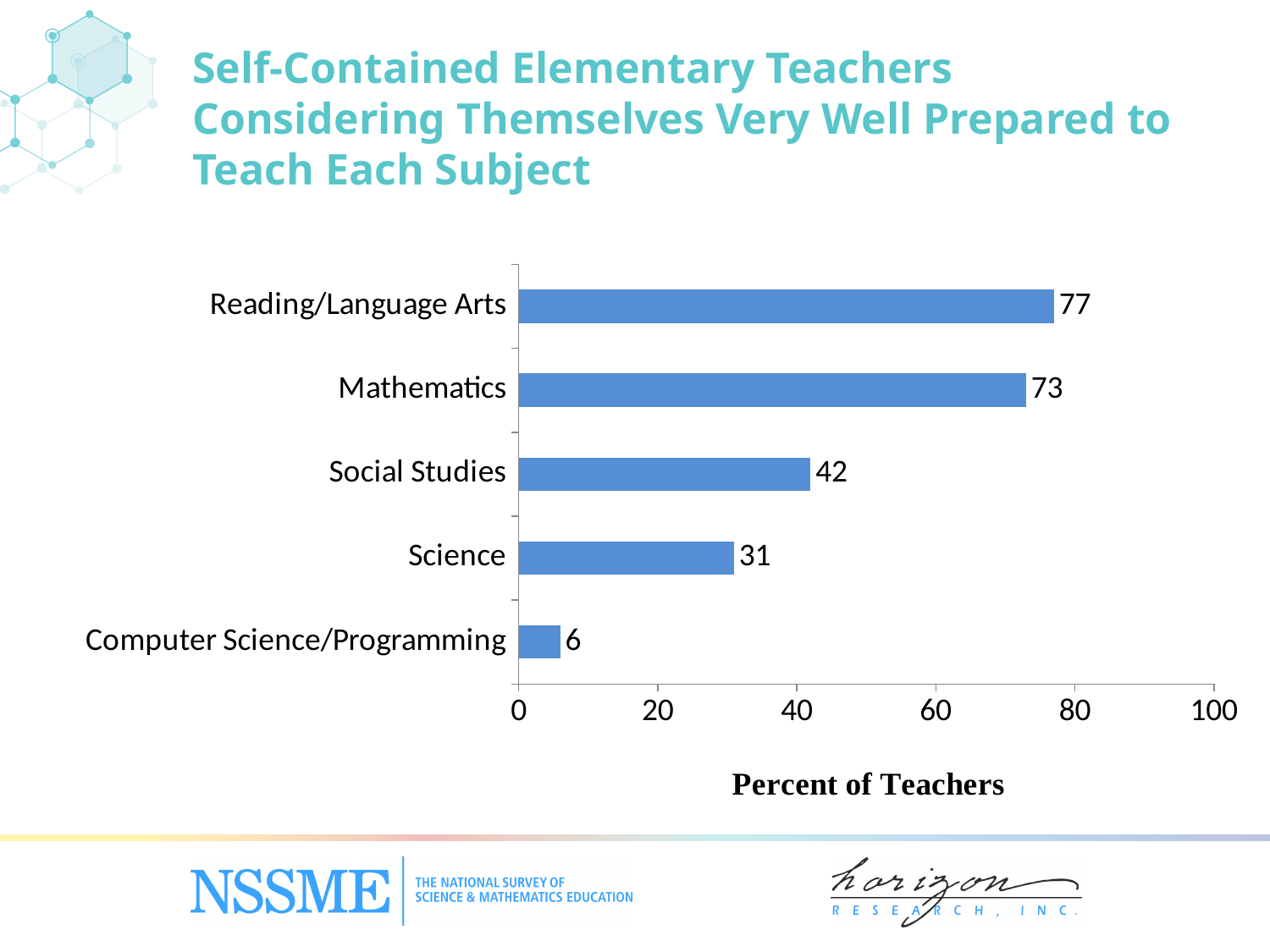
What is the difference between the values for Science and Computer Science/Programming? 25 What is the value for Science? 31 What is the difference between the values for Mathematics and Social Studies? 31 What percent of teachers considered themselves very well prepared to teach Reading/Language Arts? 77 Which subject has the highest percent of teachers? Reading/Language Arts What is the label of the horizontal axis? Percent of Teachers Which is larger, the value for Social Studies or the value for Science? Social Studies How many subjects are shown in the chart? 5 What kind of chart is shown on the slide? bar chart What is the value for Computer Science/Programming? 6 Is the value for Mathematics greater or less than 60? greater Which subject has the lowest percent of teachers? Computer Science/Programming